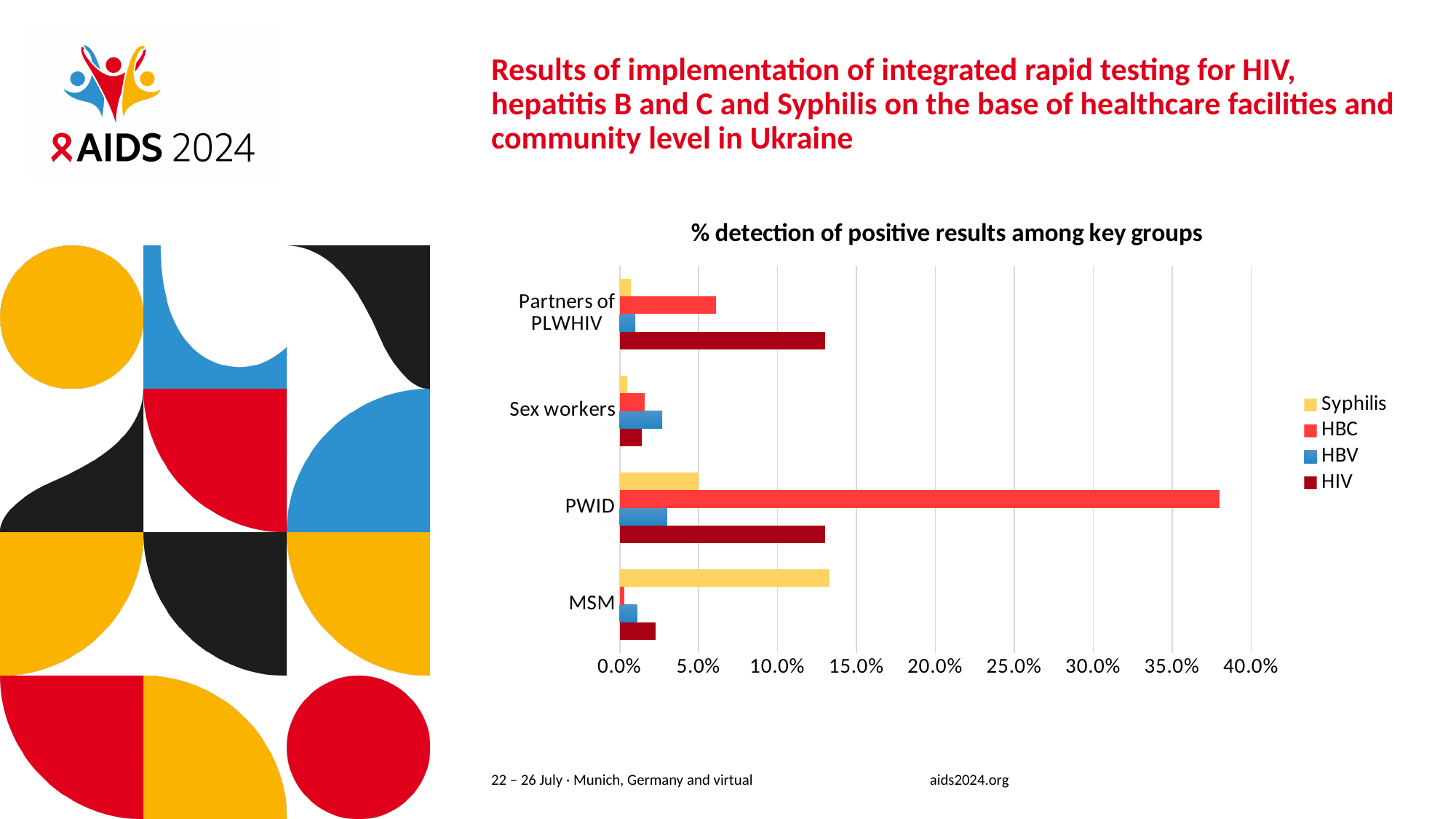
How many key groups are shown on the chart? 4 Which key group has the highest HBC detection rate? PWID Which key group has the lowest HBC detection rate? MSM Which key group has the highest Syphilis detection rate? MSM Is the Syphilis value for MSM greater or less than 10.0%? greater Is the HBC value for PWID greater or less than 35.0%? greater How many series does the legend list? 4 For PWID, which is larger: the HBC value or the HIV value? HBC What kind of chart is shown on the slide? bar chart For Sex workers, which is larger: the HBV value or the Syphilis value? HBV What is the title of the chart? % detection of positive results among key groups Is the HIV value for Partners of PLWHIV greater or less than 10.0%? greater